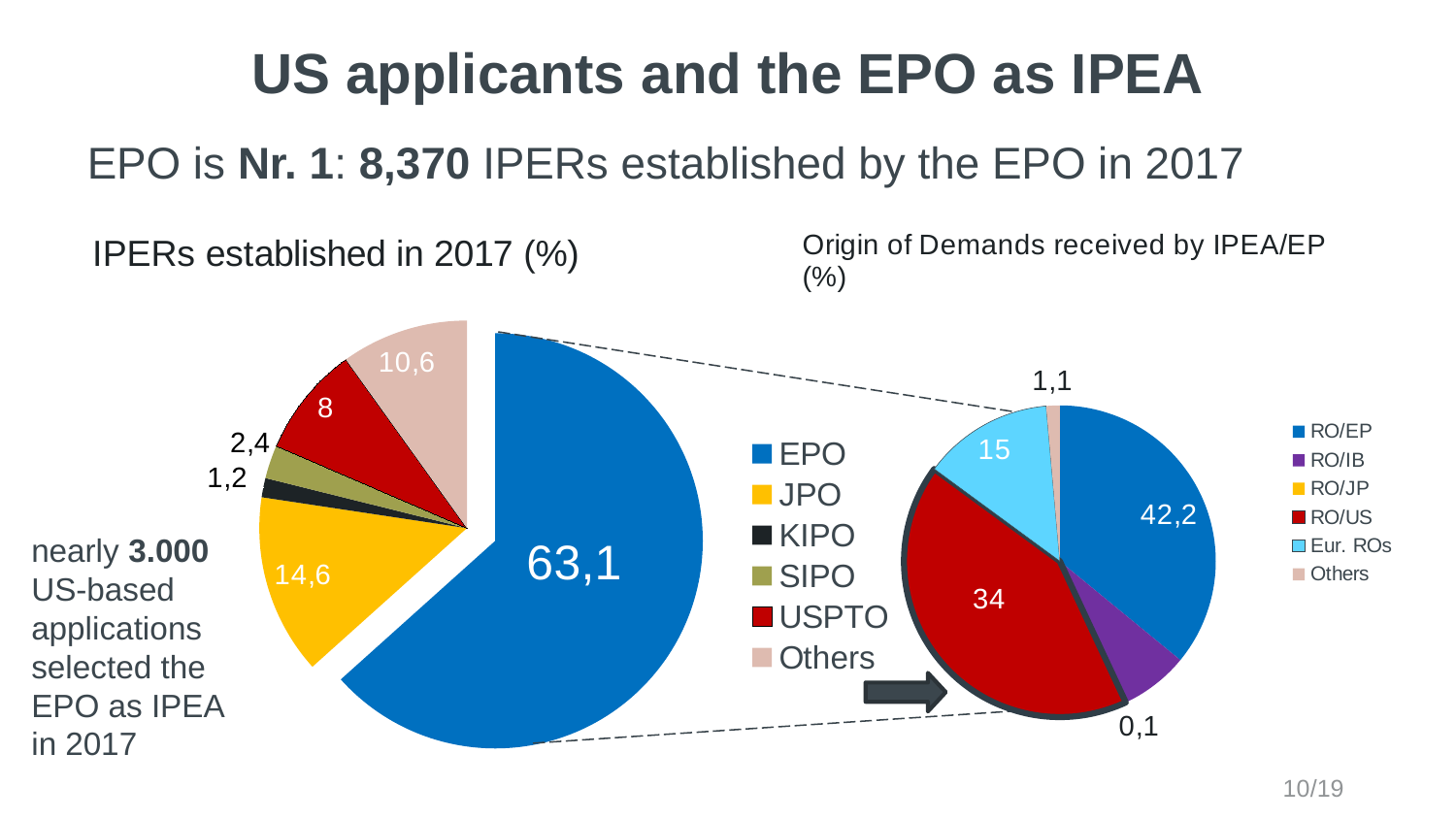
In the 'IPERs established in 2017 (%)' pie chart, which category has the smallest share? KIPO In the 'Origin of Demands received by IPEA/EP (%)' pie chart, what is the value for RO/EP? 42,2 In the 'IPERs established in 2017 (%)' pie chart, what is the value for EPO? 63,1 How many categories does the legend of the 'IPERs established in 2017 (%)' pie chart list? 6 In the 'IPERs established in 2017 (%)' pie chart, what is the value for USPTO? 8 In the 'Origin of Demands received by IPEA/EP (%)' pie chart, what is the value for RO/US? 34 In the 'IPERs established in 2017 (%)' pie chart, what is the value for JPO? 14,6 In the 'Origin of Demands received by IPEA/EP (%)' pie chart, what is the value for Eur. ROs? 15 In the 'IPERs established in 2017 (%)' pie chart, which is larger, SIPO or KIPO? SIPO What type of chart is used for 'Origin of Demands received by IPEA/EP (%)'? Pie chart In the 'IPERs established in 2017 (%)' pie chart, which category has the largest share? EPO In the 'IPERs established in 2017 (%)' pie chart, what is the difference between the values for JPO and USPTO? 6,6